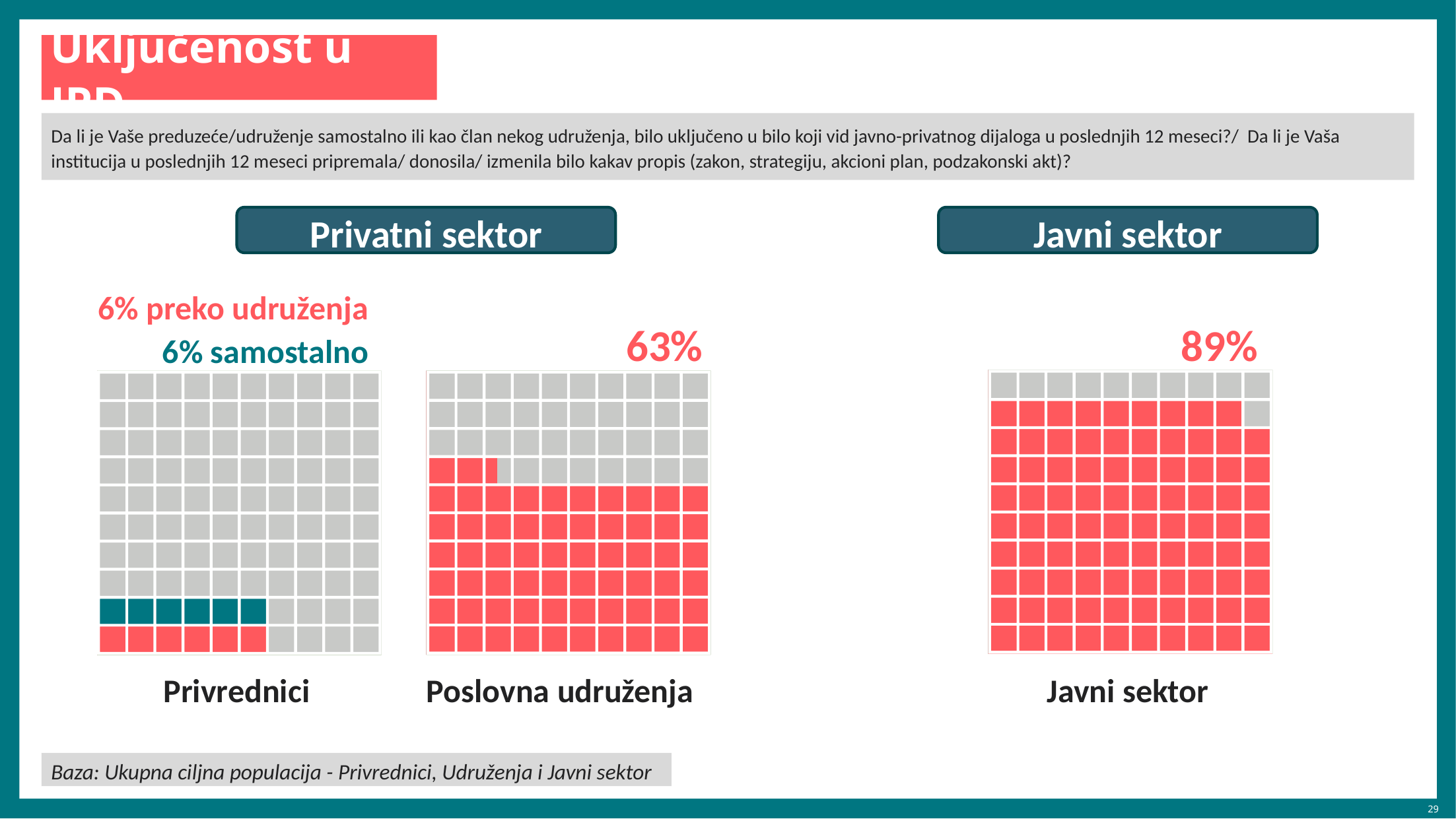
Which of the three waffle charts shows the lowest percentages? Privrednici What is the difference between the Javni sektor percentage and the Poslovna udruženja percentage? 26% Which is larger, the percentage for Poslovna udruženja or for Javni sektor? Javni sektor What kind of chart is used to show the percentages on this slide? Waffle chart In the Privrednici chart, what percentage is labelled 'samostalno'? 6% How many waffle charts are shown on the slide? 3 In the Privrednici chart, what percentage is labelled 'preko udruženja'? 6% Which of the three waffle charts shows the highest percentage? Javni sektor In the Privrednici chart, what colour are the squares representing 'samostalno'? Teal Which two charts are grouped under the heading 'Privatni sektor'? Privrednici and Poslovna udruženja In the Javni sektor chart, what percentage is shown? 89% In the Poslovna udruženja chart, what percentage is shown? 63%